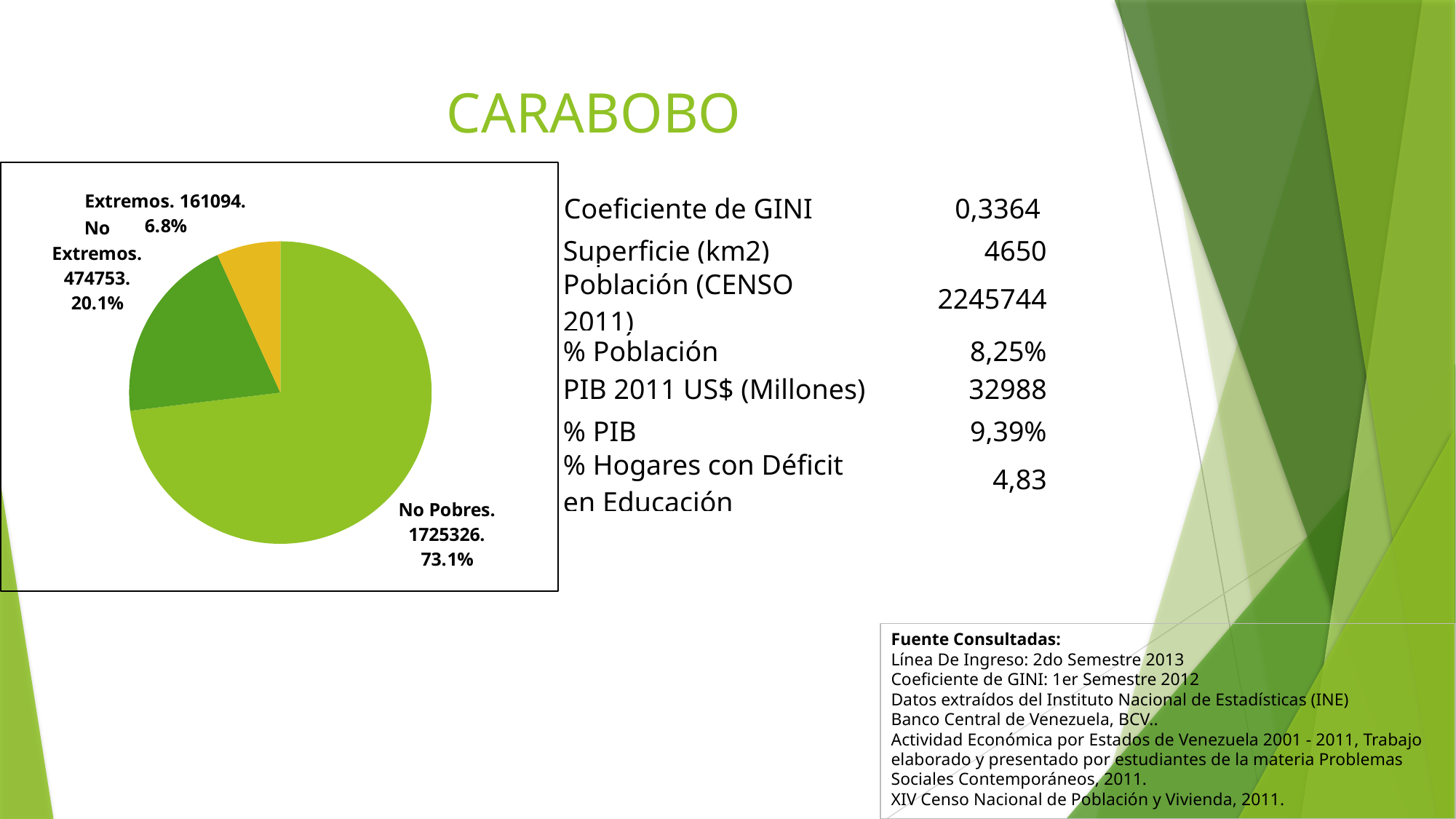
Which slice of the pie chart is the smallest? Extremos What kind of chart is shown on the slide? pie chart What value is shown for the No Extremos slice? 474753 What value is shown for the No Pobres slice? 1725326 What percentage share does the Extremos slice have? 6.8% Which is larger, the No Extremos slice or the Extremos slice? No Extremos What percentage share does the No Extremos slice have? 20.1% What percentage share does the No Pobres slice have? 73.1% Which slice of the pie chart is the largest? No Pobres What is the difference between the No Extremos value and the Extremos value? 313659 How many slices does the pie chart have? 3 What value is shown for the Extremos slice? 161094